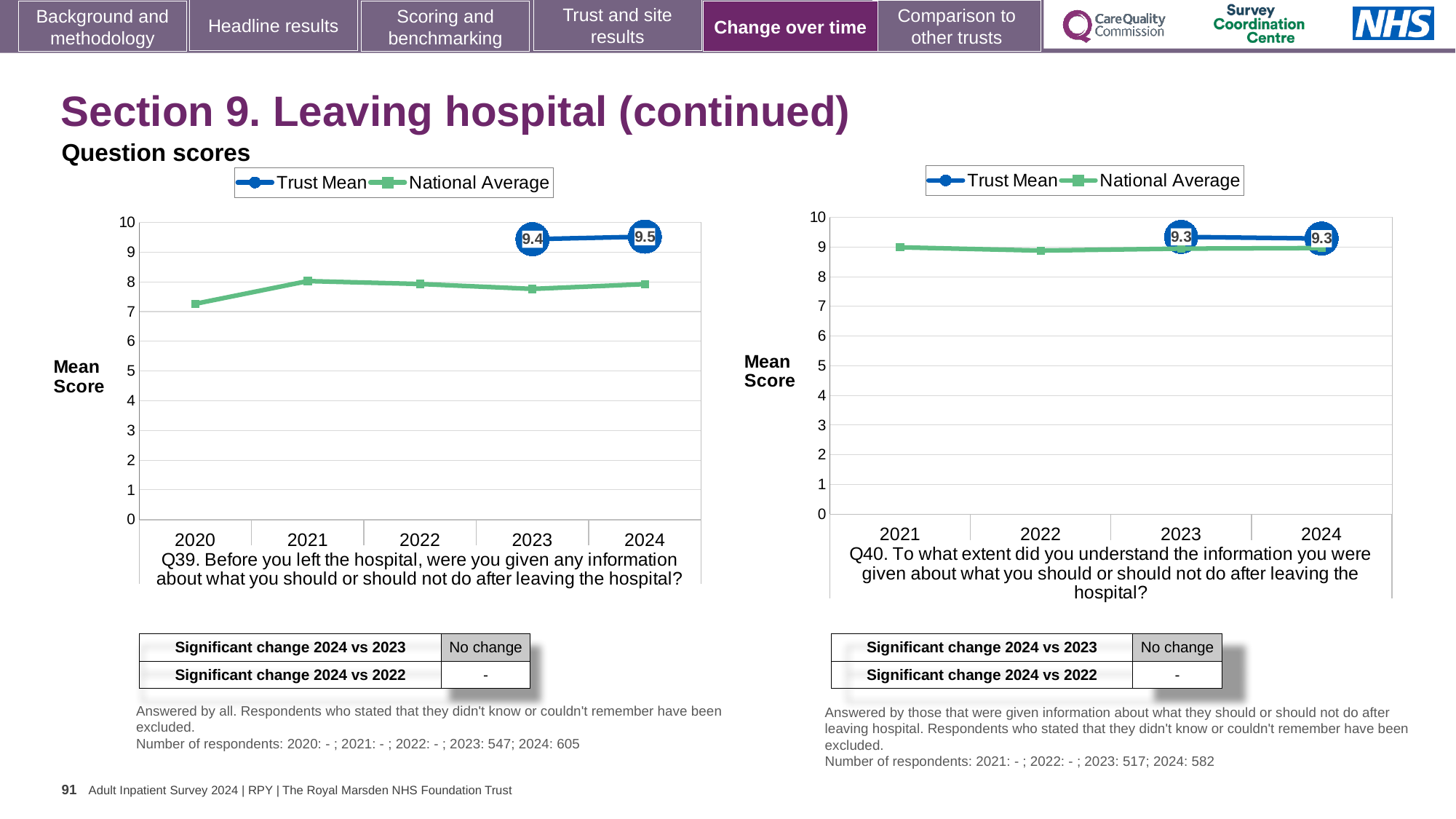
In the Q40 chart on the right, what is the Trust Mean score for 2024? 9.3 How many series does the legend of the Q39 chart on the left list? 2 In the Q39 chart on the left, what is the difference between the Trust Mean scores for 2024 and 2023? 0.1 What type of chart is the Q40 chart on the right? Line chart How many years are shown on the x axis of the Q40 chart on the right? 4 In the Q39 chart on the left, is the National Average for 2020 greater or less than 8? less In the Q40 chart on the right, which is larger in 2024, the Trust Mean or the National Average? Trust Mean In the Q40 chart on the right, what is the Trust Mean score for 2023? 9.3 In the Q39 chart on the left, is the Trust Mean for 2024 greater or less than 9? greater In the Q39 chart on the left, what is the Trust Mean score for 2023? 9.4 How many years are shown on the x axis of the Q39 chart on the left? 5 In the Q39 chart on the left, what is the Trust Mean score for 2024? 9.5